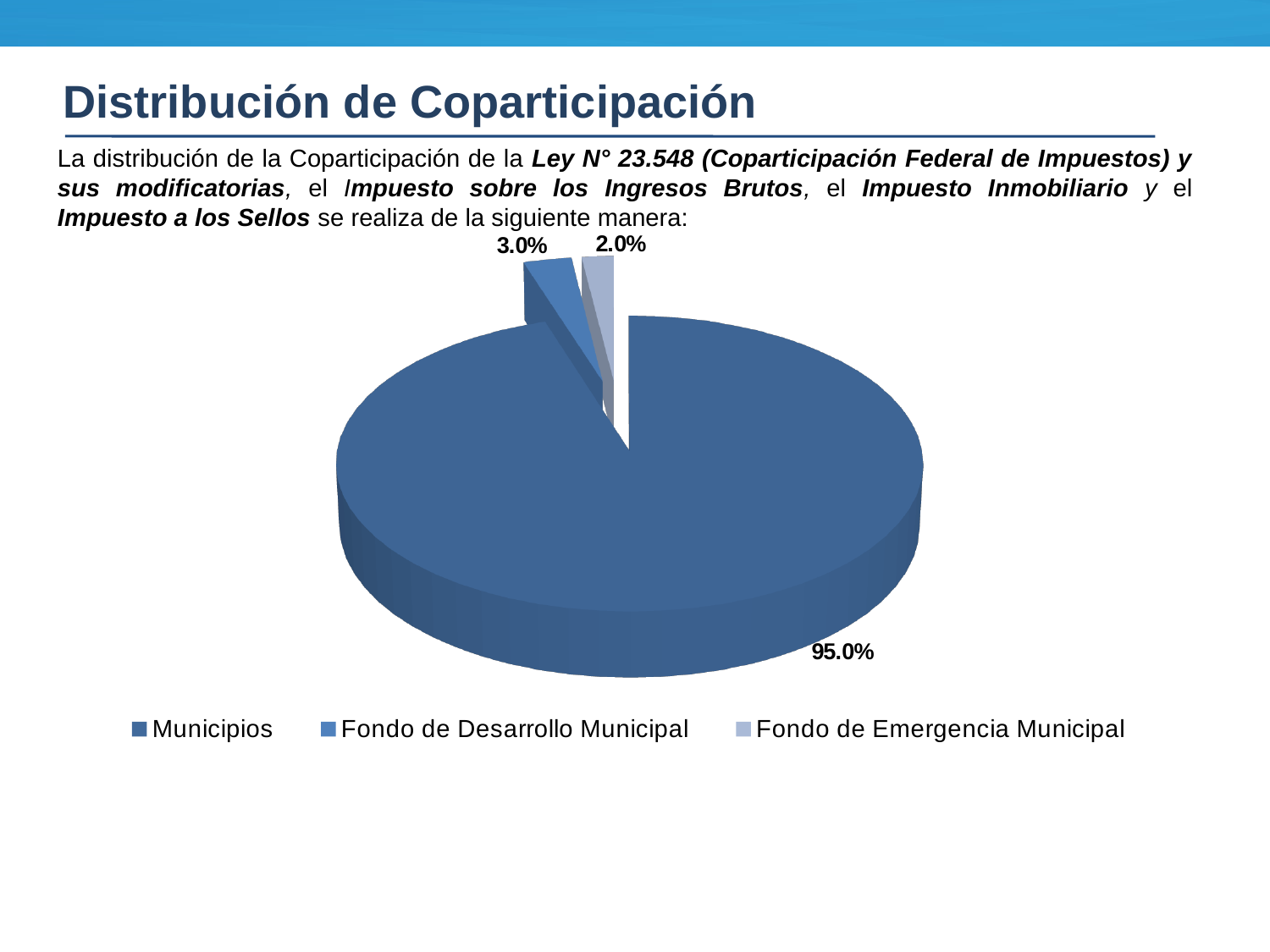
Which is larger, the share for Fondo de Desarrollo Municipal or the share for Fondo de Emergencia Municipal? Fondo de Desarrollo Municipal Which category has the smallest slice of the pie? Fondo de Emergencia Municipal How many categories does the legend list? 3 What kind of chart is shown on the slide? Pie chart What is the difference between the shares of Fondo de Desarrollo Municipal and Fondo de Emergencia Municipal? 1.0% What is the title of the slide containing the chart? Distribución de Coparticipación What is the combined share of Fondo de Desarrollo Municipal and Fondo de Emergencia Municipal? 5.0% What share of the pie does Fondo de Desarrollo Municipal receive? 3.0% Which category has the largest slice of the pie? Municipios What share of the pie does Fondo de Emergencia Municipal receive? 2.0% What is the difference between the shares of Municipios and Fondo de Desarrollo Municipal? 92.0% What share of the pie does Municipios receive? 95.0%